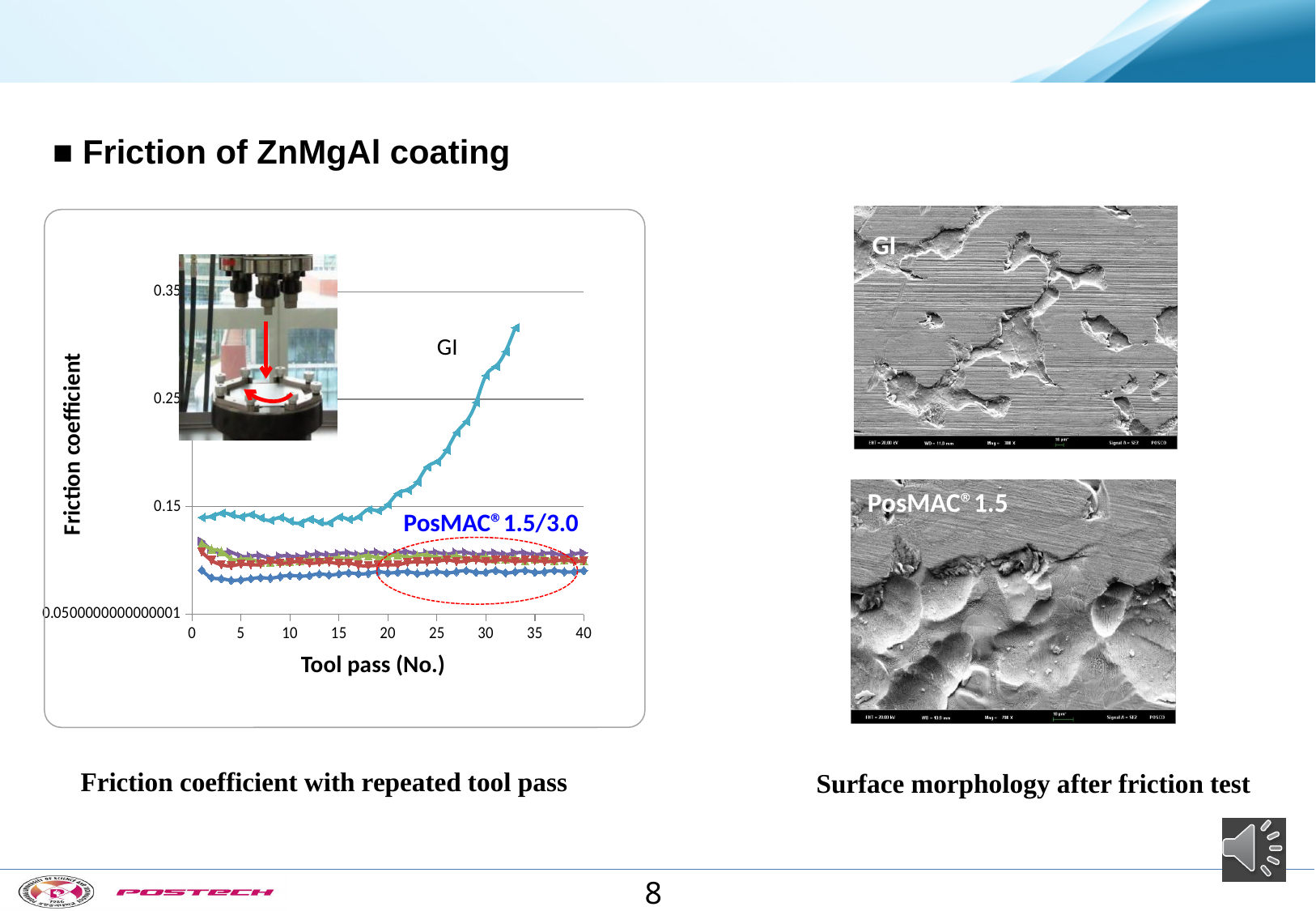
In the friction chart, does the GI series rise or fall as the tool pass number increases? rise In the friction chart, is the friction coefficient of the PosMAC 1.5/3.0 series at tool pass 40 greater or less than 0.15? less What kind of chart is shown on the left of the slide? line chart What is the highest tool pass number shown on the x-axis of the friction chart? 40 What is the y-axis label of the friction chart? Friction coefficient In the friction chart, which has the higher friction coefficient at tool pass 30, GI or PosMAC 1.5/3.0? GI What is the x-axis label of the friction chart? Tool pass (No.) In the friction chart, which series reaches the highest friction coefficient? GI In the friction chart, is the friction coefficient of GI at its final point greater or less than 0.25? greater In the friction chart, is the friction coefficient of GI at tool pass 20 greater or less than 0.25? less